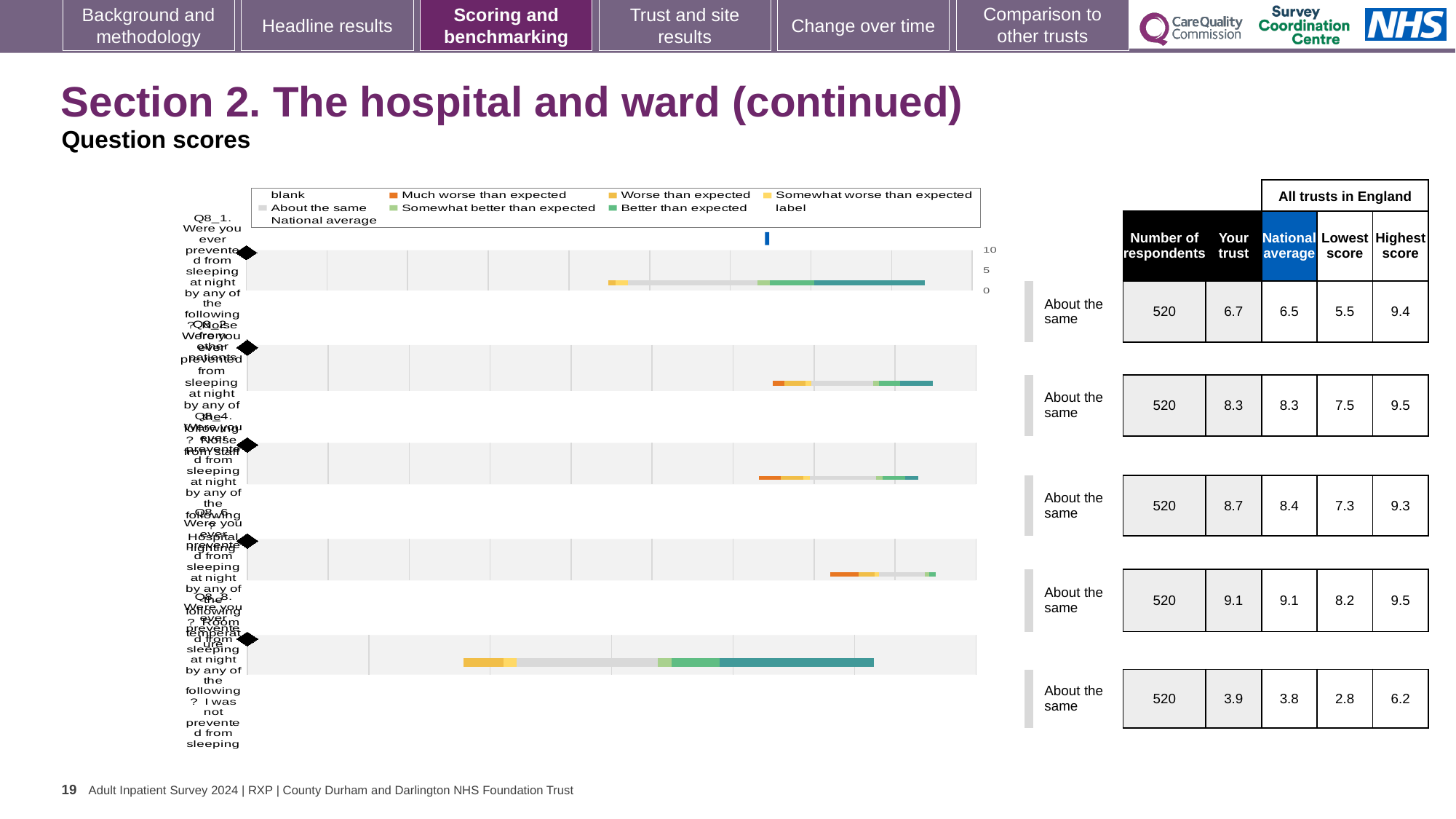
For the third row (Q8_4), what is the difference between the 'Your trust' score and the national average? 0.3 Which row has the lowest 'Your trust' score? Q8_8 (3.9) How many respondents are listed for the third row (Q8_4)? 520 What is the lowest score across all trusts in England for the fourth row (Q8_6)? 8.2 What is the 'Your trust' score for the first row (Q8_1)? 6.7 What kind of chart is shown on the slide? Horizontal stacked bar chart What benchmark label is shown next to every bar in the chart? About the same What is the national average for the last row (Q8_8)? 3.8 What is the highest score across all trusts in England for the second row (Q8_2)? 9.5 How many question rows (bars) does the chart show? 5 Which row has the highest 'Your trust' score? Q8_6 (9.1) For the first row (Q8_1), which is larger: the 'Your trust' score or the national average? Your trust